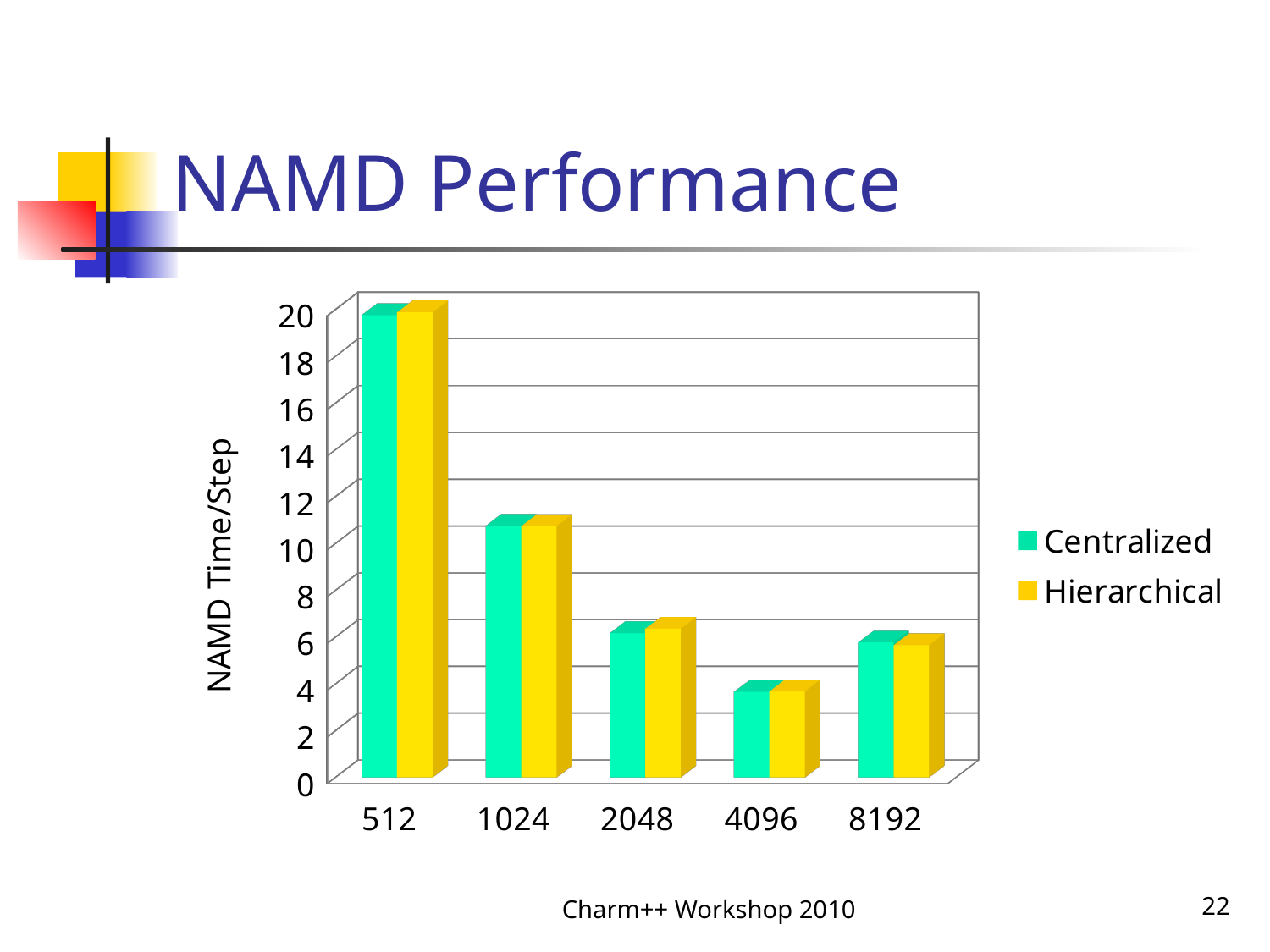
Do the values rise or fall from 512 to 4096 along the x axis? fall What kind of chart is shown on the slide? bar chart Is the Hierarchical value for 1024 greater or less than 8? greater Which has the larger Centralized value, 1024 or 2048? 1024 Is the Centralized value for 512 greater or less than 16? greater How many series does the legend list? 2 Is the Hierarchical value for 8192 greater or less than 4? greater How many categories are shown on the x axis? 5 Which category has the highest NAMD Time/Step? 512 Which category has the lowest NAMD Time/Step? 4096 What is the label on the y axis? NAMD Time/Step